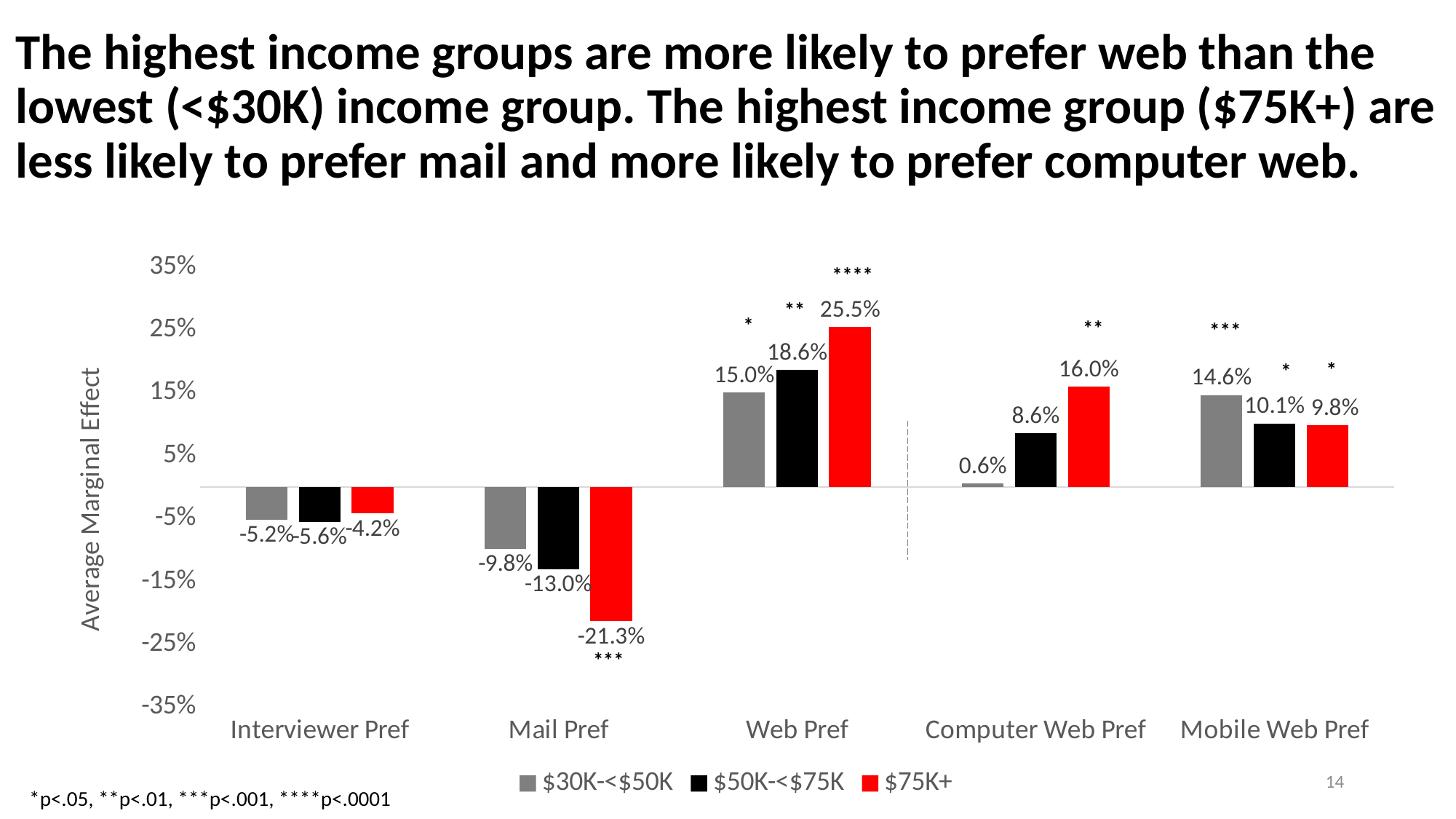
Which category has the lowest value for the $75K+ series? Mail Pref In the Mobile Web Pref category, which series has the larger value: $30K-<$50K or $75K+? $30K-<$50K What is the value for the $30K-<$50K series in the Mail Pref category? -9.8% What kind of chart is shown on the slide? Bar chart What is the value for the $30K-<$50K series in the Mobile Web Pref category? 14.6% What is the difference between the $75K+ and $30K-<$50K values in the Web Pref category? 10.5% What is the value for the $50K-<$75K series in the Computer Web Pref category? 8.6% How many series does the legend list? 3 What is the label of the y axis? Average Marginal Effect How many categories are shown on the x axis? 5 Which category has the highest value for the $50K-<$75K series? Web Pref What is the value for the $75K+ series in the Web Pref category? 25.5%